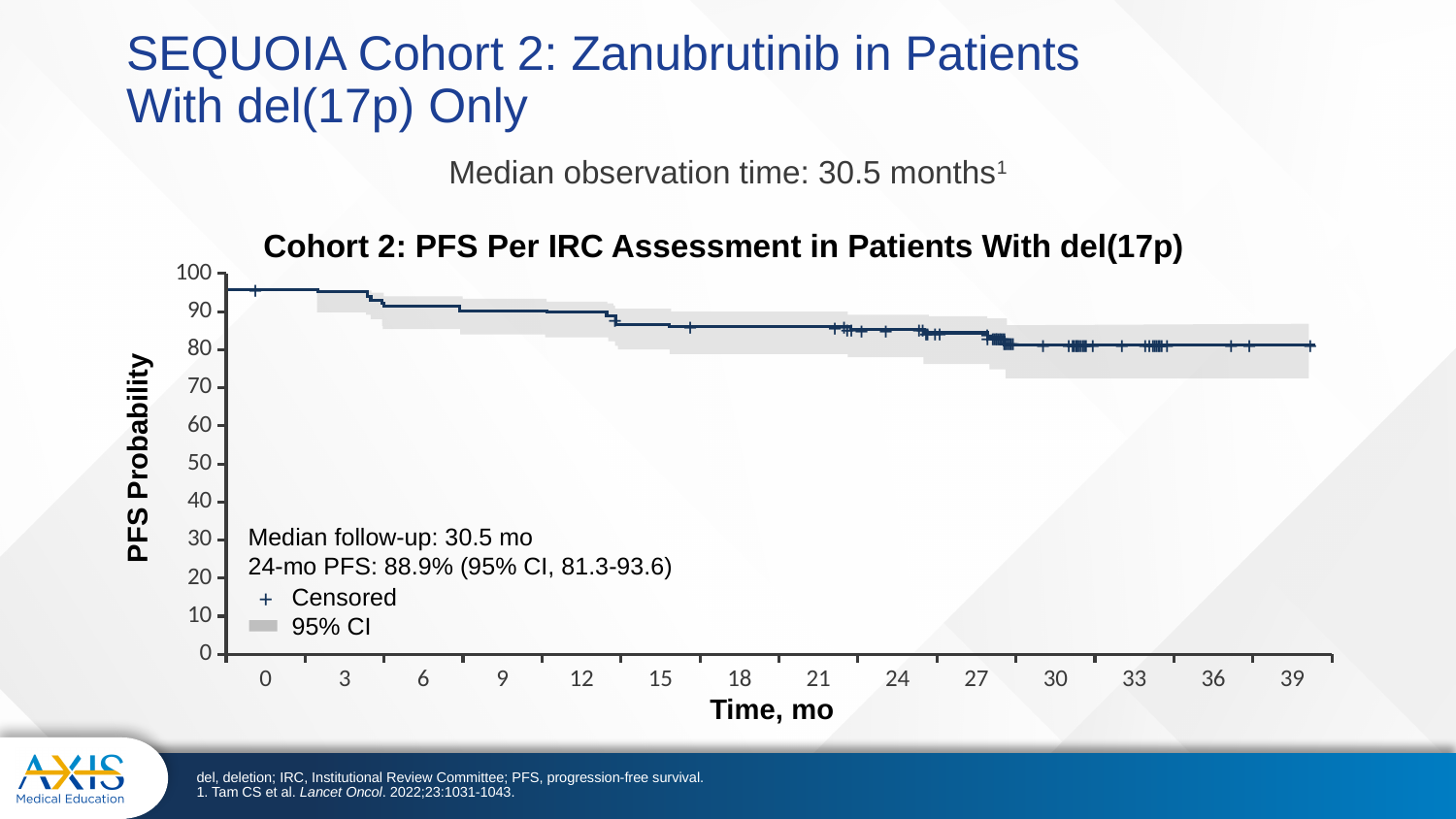
Is the PFS probability higher at 6 months or at 33 months? 6 months What does the shaded grey band around the curve represent, according to the legend? 95% CI Is the PFS probability at 12 months greater or less than 80? greater Is the PFS probability at 36 months greater or less than 70? greater What is the 95% CI for the 24-month PFS stated on the chart? 81.3-93.6 What is the label of the x axis? Time, mo What is the 24-month PFS rate stated on the chart? 88.9% Is the PFS probability at 3 months greater or less than 90? greater What kind of chart is shown on the slide? line chart What median follow-up is stated on the chart? 30.5 mo Does the PFS probability curve rise or fall as time increases along the x axis? fall